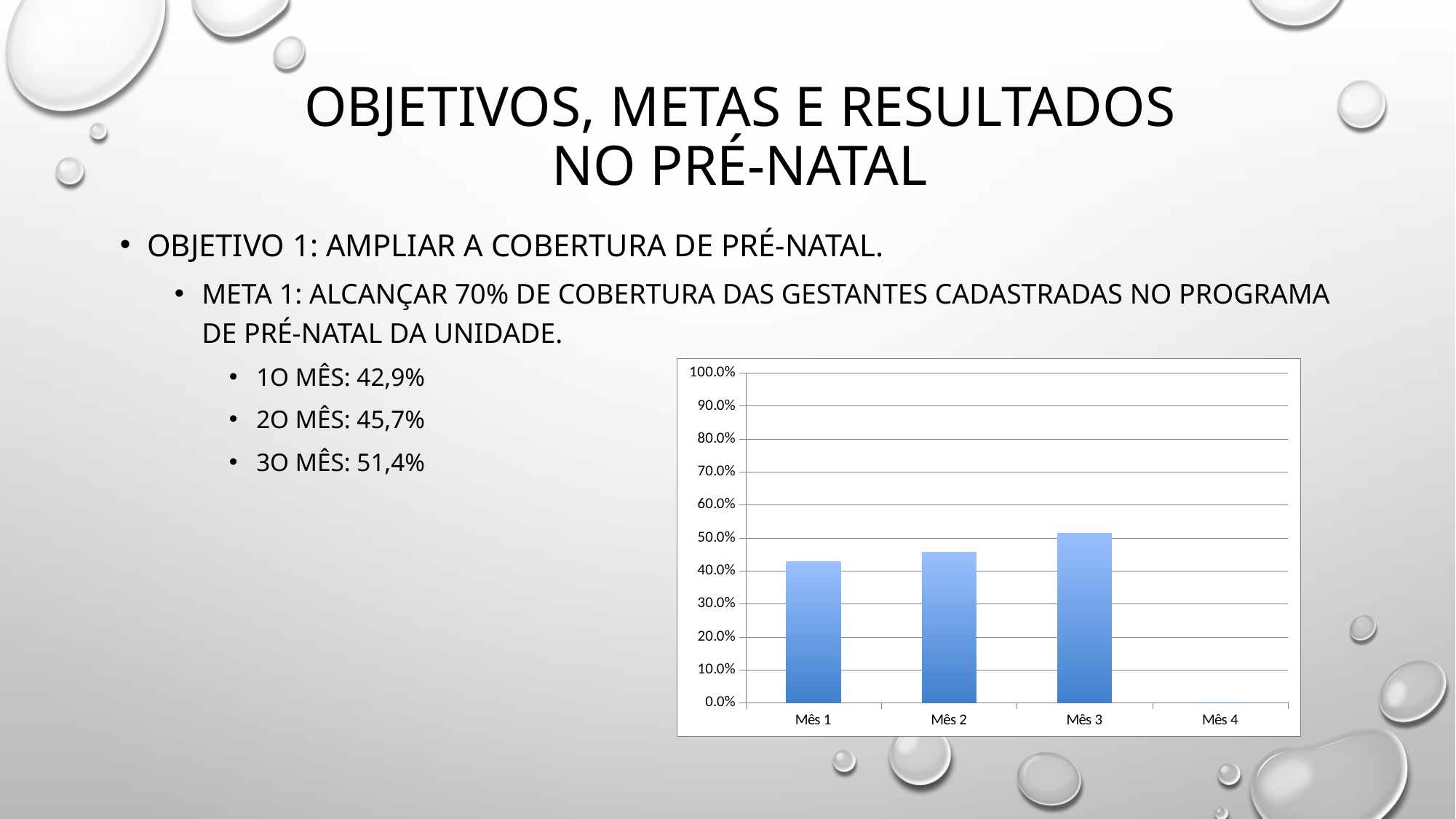
Is the value for Mês 3 greater or less than 50.0%? greater Which month has the lowest bar among the months with a plotted bar? Mês 1 Which is larger, the value for Mês 3 or the value for Mês 1? Mês 3 Which month has the highest bar in the chart? Mês 3 What kind of chart is shown on the slide? bar chart How many categories are shown on the x axis of the chart? 4 According to the slide, what is the coverage value for the 3rd month (Mês 3)? 51,4% Which month on the x axis has no bar plotted? Mês 4 Is the value for Mês 2 greater or less than 40.0%? greater Do the bar values rise or fall from Mês 1 to Mês 3? rise Is the value for Mês 1 greater or less than 50.0%? less According to the slide, what is the coverage value for the 1st month (Mês 1)? 42,9%